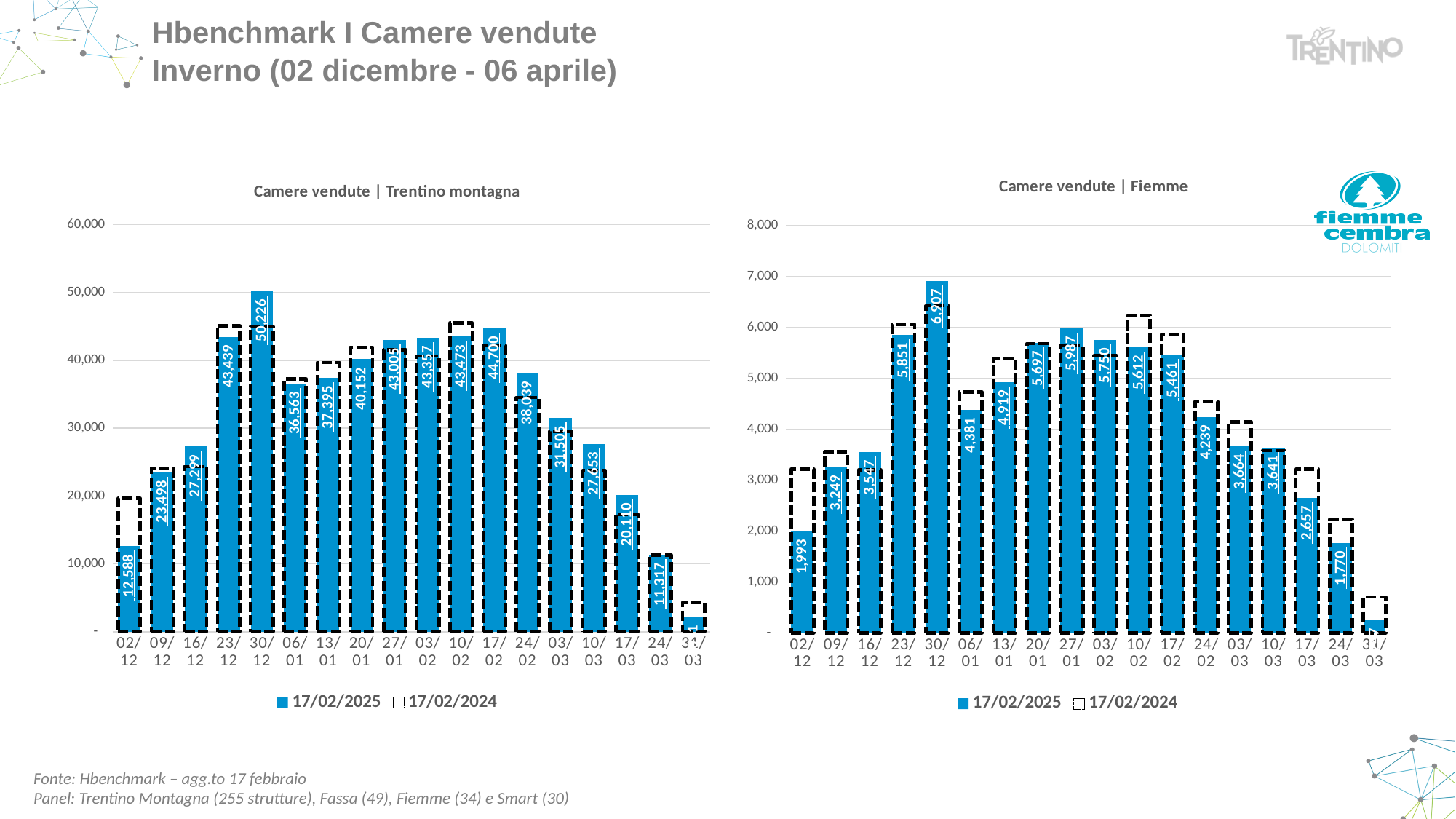
What kind of chart is 'Camere vendute | Fiemme'? Bar chart In the 'Camere vendute | Trentino montagna' chart, what is the difference between the 17/02/2025 values for 30/12 and 23/12? 6,787 In the 'Camere vendute | Trentino montagna' chart, what is the 17/02/2025 value for 30/12? 50,226 What are the two legend entries in the 'Camere vendute | Trentino montagna' chart? 17/02/2025 and 17/02/2024 In the 'Camere vendute | Fiemme' chart, what is the 17/02/2025 value for 17/03? 2,657 In the 'Camere vendute | Fiemme' chart, which week has the highest 17/02/2025 value? 30/12 How many series does the legend of the 'Camere vendute | Trentino montagna' chart list? 2 In the 'Camere vendute | Fiemme' chart, which week has the larger 17/02/2025 value, 20/01 or 27/01? 27/01 In the 'Camere vendute | Trentino montagna' chart, which week has the highest 17/02/2025 value? 30/12 In the 'Camere vendute | Trentino montagna' chart, is the 17/02/2024 value for 10/02 greater or less than 40,000? greater In the 'Camere vendute | Fiemme' chart, what is the 17/02/2025 value for 23/12? 5,851 How many weeks are shown on the x axis of the 'Camere vendute | Fiemme' chart? 18